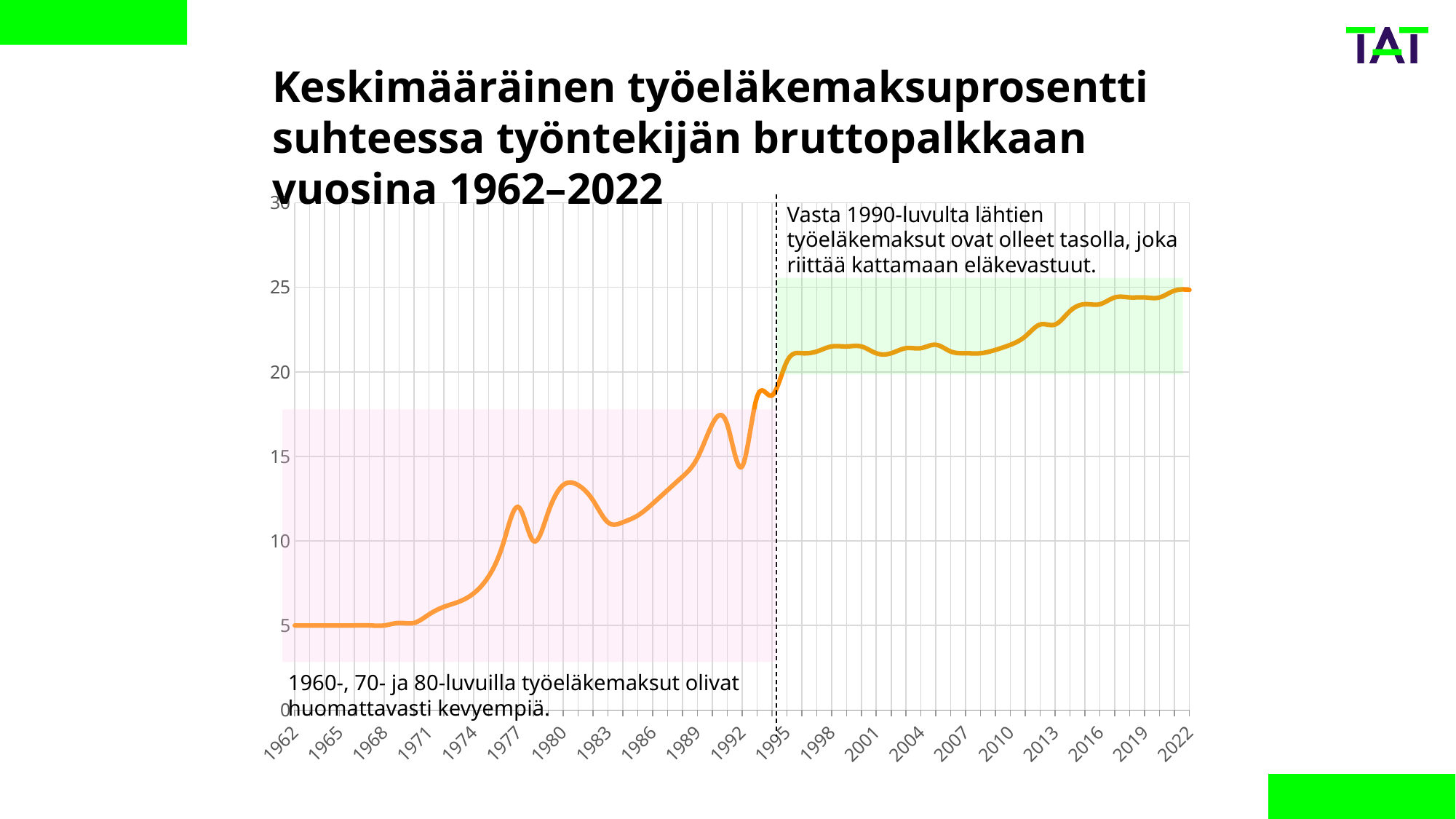
What kind of chart is shown on the slide? line chart Is the value for 1983 greater or less than 10? greater Overall, do the values rise or fall from 1962 to 2022? rise What is the title of the chart? Keskimääräinen työeläkemaksuprosentti suhteessa työntekijän bruttopalkkaan vuosina 1962–2022 Is the value for 1962 greater or less than 10? less How many year labels are shown on the x axis? 21 Is the value for 2001 greater or less than 20? greater Which year has the larger value, 2001 or 2013? 2013 Which year has the larger value, 1962 or 2022? 2022